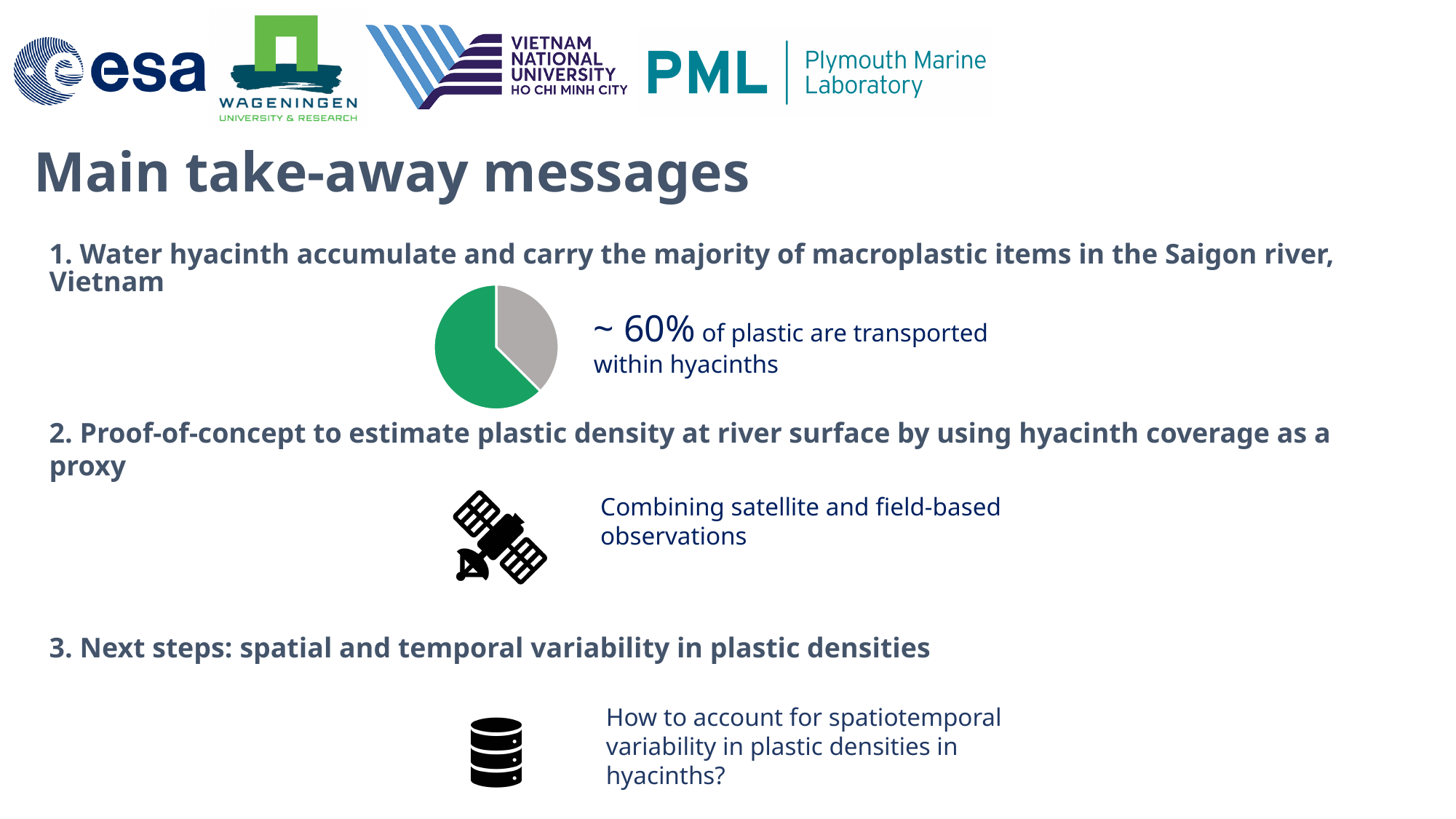
How many slices does the pie chart have? 2 Which slice of the pie chart is the smallest? grey Which slice of the pie chart is larger, the green one or the grey one? green What colour is the larger slice of the pie chart? green What kind of chart is shown under the first take-away message? pie chart Does the green slice of the pie chart represent more or less than half of the pie? more Which slice of the pie chart is the largest? green